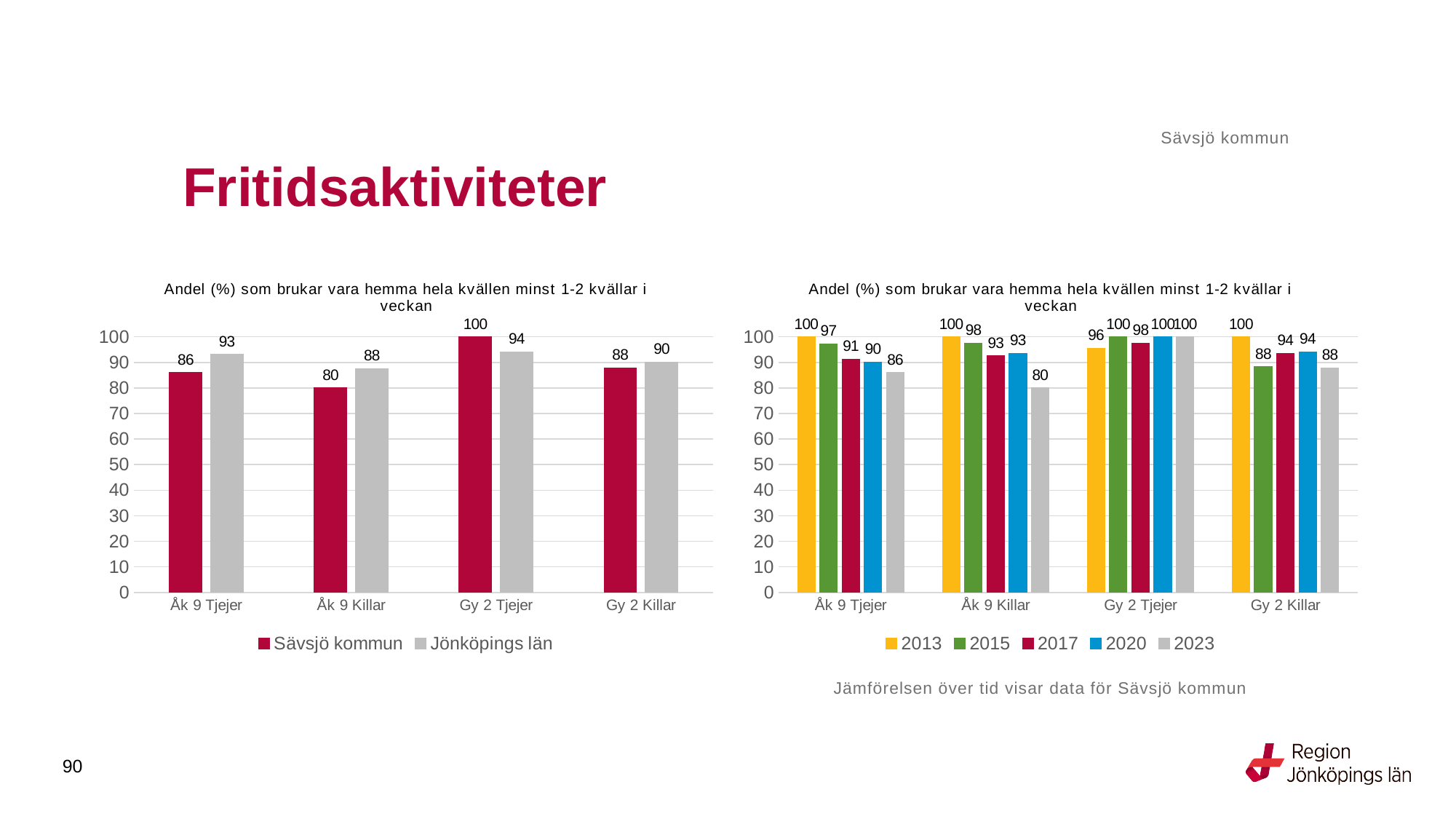
In the right chart, what is the value for 2023 for Åk 9 Killar? 80 In the left chart, what is the value for Jönköpings län for Gy 2 Tjejer? 94 How many series does the legend of the right chart list? 5 What type of chart is the left chart? Bar chart In the left chart, which is larger for Gy 2 Killar: Sävsjö kommun or Jönköpings län? Jönköpings län In the right chart, what is the difference between 2013 and 2023 for Gy 2 Killar? 12 In the right chart, what is the value for 2015 for Gy 2 Killar? 88 In the left chart, what is the difference between Jönköpings län and Sävsjö kommun for Åk 9 Tjejer? 7 In the left chart, which category has the lowest value for Jönköpings län? Åk 9 Killar In the left chart, what is the value for Sävsjö kommun for Åk 9 Killar? 80 In the right chart, which year has the lowest value for Åk 9 Tjejer? 2023 In the left chart, which category has the highest value for Sävsjö kommun? Gy 2 Tjejer